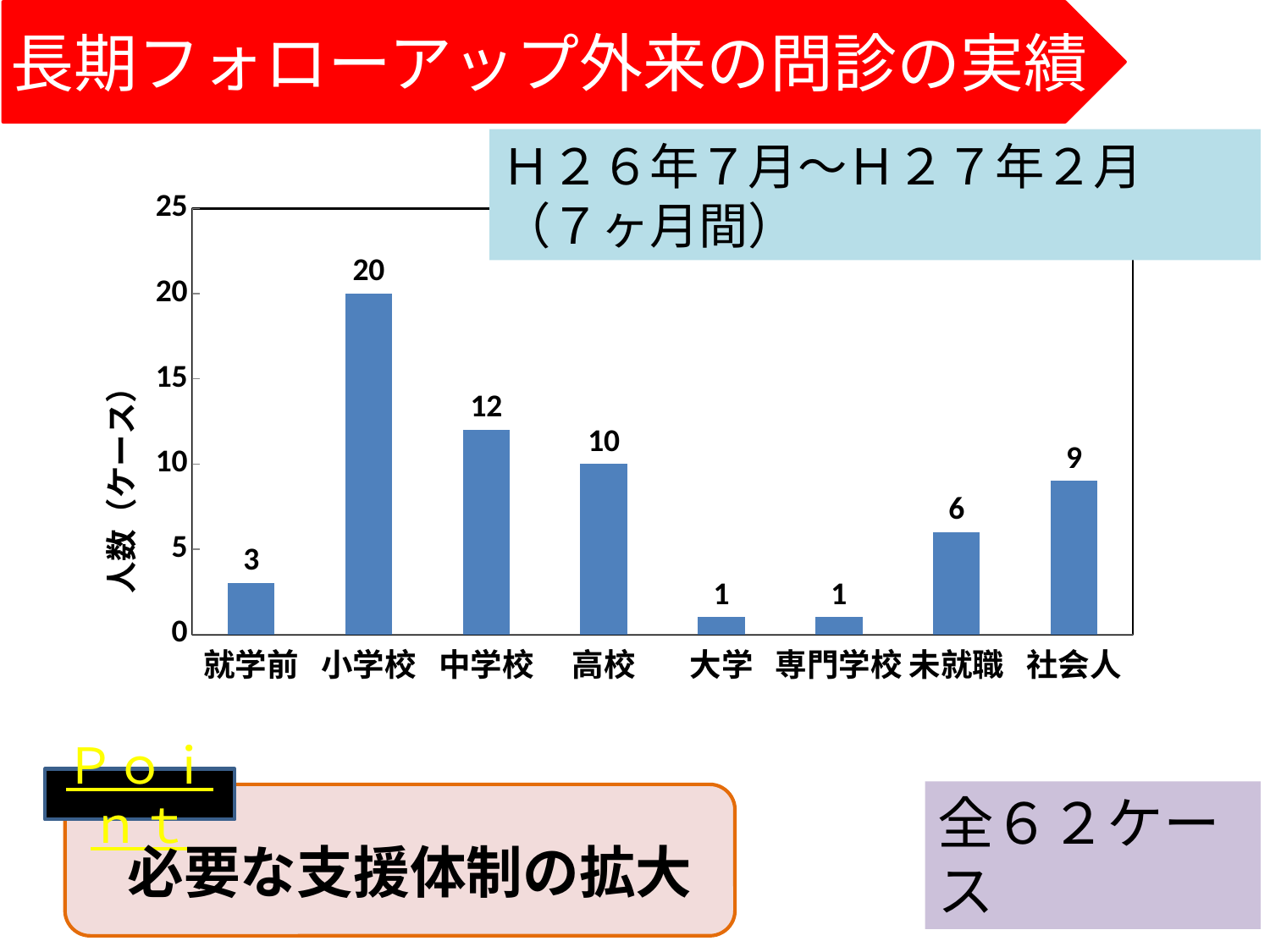
Which categories share the lowest value? 大学 and 専門学校 How many categories are shown on the x axis? 8 Which category has the highest value? 小学校 What is the value for 小学校? 20 Is the value for 中学校 greater or less than 10? greater Which is larger, the value for 社会人 or the value for 未就職? 社会人 What is the value for 未就職? 6 What kind of chart is shown on the slide? bar chart What is the label of the y axis? 人数（ケース） What is the value for 社会人? 9 What is the difference between the values for 小学校 and 中学校? 8 What is the difference between the values for 高校 and 就学前? 7